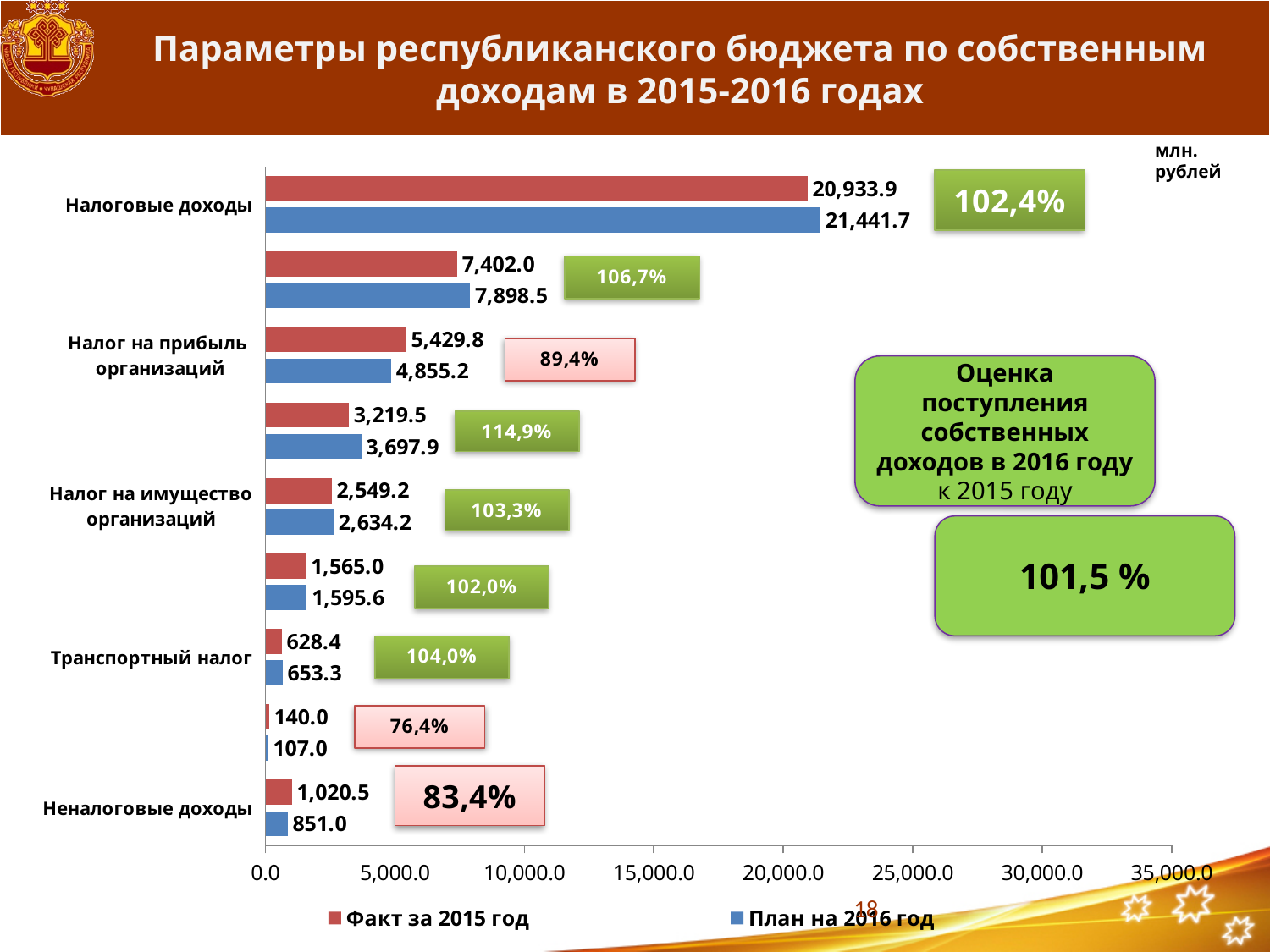
For Налог на прибыль организаций, which is larger: Факт за 2015 год or План на 2016 год? Факт за 2015 год What is the План на 2016 год value for Налог на имущество организаций? 2,634.2 What kind of chart is shown on the slide? Bar chart How many series does the legend list? 2 Which category has the highest План на 2016 год value? Налоговые доходы What is the value of План на 2016 год for Налоговые доходы? 21,441.7 What is the difference between Факт за 2015 год and План на 2016 год for Неналоговые доходы? 169.5 What is the Факт за 2015 год value for Налог на прибыль организаций? 5,429.8 What is the value of Факт за 2015 год for Налоговые доходы? 20,933.9 What is the План на 2016 год value for Транспортный налог? 653.3 By how much does План на 2016 год exceed Факт за 2015 год for Налоговые доходы? 507.8 What is the Факт за 2015 год value for Неналоговые доходы? 1,020.5